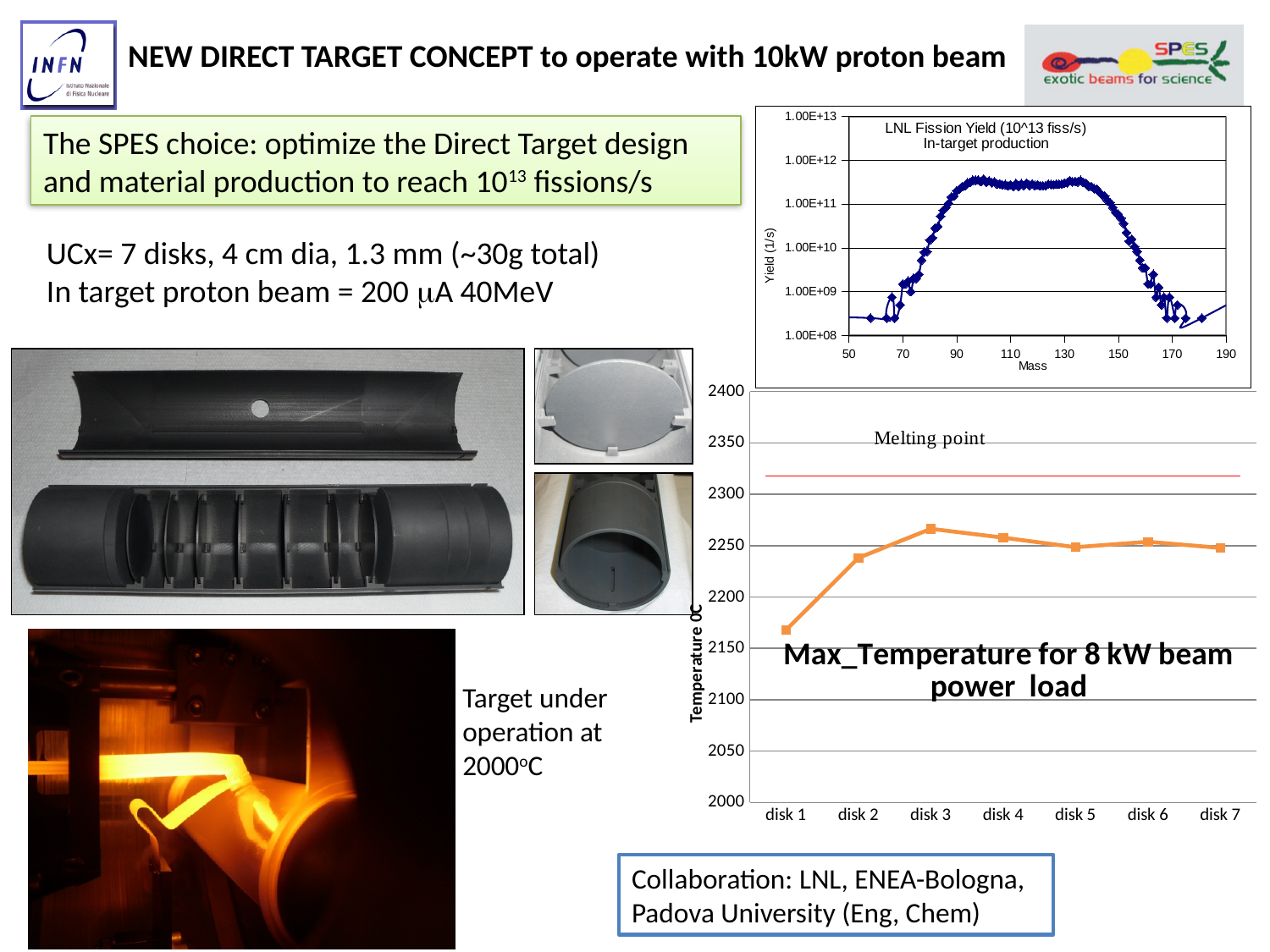
On the 'LNL Fission Yield' chart, does the yield rise or fall as mass increases from 140 to 170? fall On the 'Max_Temperature for 8 kW beam power load' chart, is the value for disk 2 greater or less than 2250? less On the 'Max_Temperature for 8 kW beam power load' chart, is the value for disk 1 greater or less than 2200? less On the 'Max_Temperature for 8 kW beam power load' chart, which disk has the highest temperature? disk 3 On the 'Max_Temperature for 8 kW beam power load' chart, is the 'Melting point' line above or below 2300? above What kind of chart is the 'Max_Temperature for 8 kW beam power load' chart? line chart How many disks are plotted on the 'Max_Temperature for 8 kW beam power load' chart? 7 On the 'Max_Temperature for 8 kW beam power load' chart, which disk has the lowest temperature? disk 1 On the 'Max_Temperature for 8 kW beam power load' chart, is the temperature for disk 2 larger or smaller than for disk 1? larger On the 'Max_Temperature for 8 kW beam power load' chart, what is the y-axis label? Temperature 0C